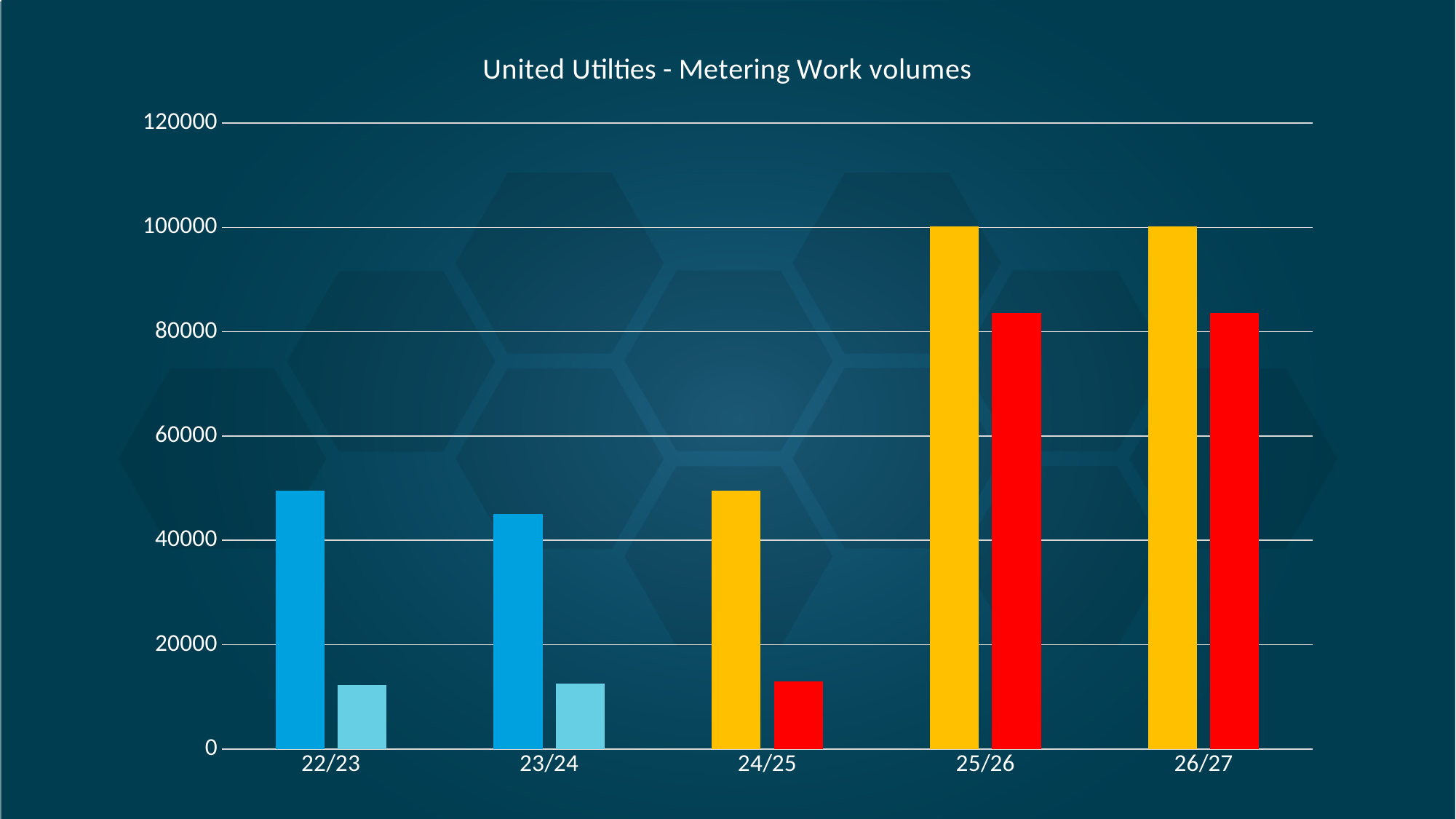
Is the value of the right (red) bar for 25/26 greater or less than 80000? greater Is the value of the right (light blue) bar for 23/24 greater or less than 20000? less Which is larger, the left (yellow) bar for 24/25 or the left (yellow) bar for 25/26? the left bar for 25/26 What is the title of the chart? United Utilties - Metering Work volumes Which is larger for 22/23, the left bar or the right bar? the left bar How many categories are shown on the x axis of the chart? 5 What is the highest value shown on the y axis of the chart? 120000 What kind of chart is shown on the slide? bar chart Is the value of the right (red) bar for 24/25 greater or less than 20000? less